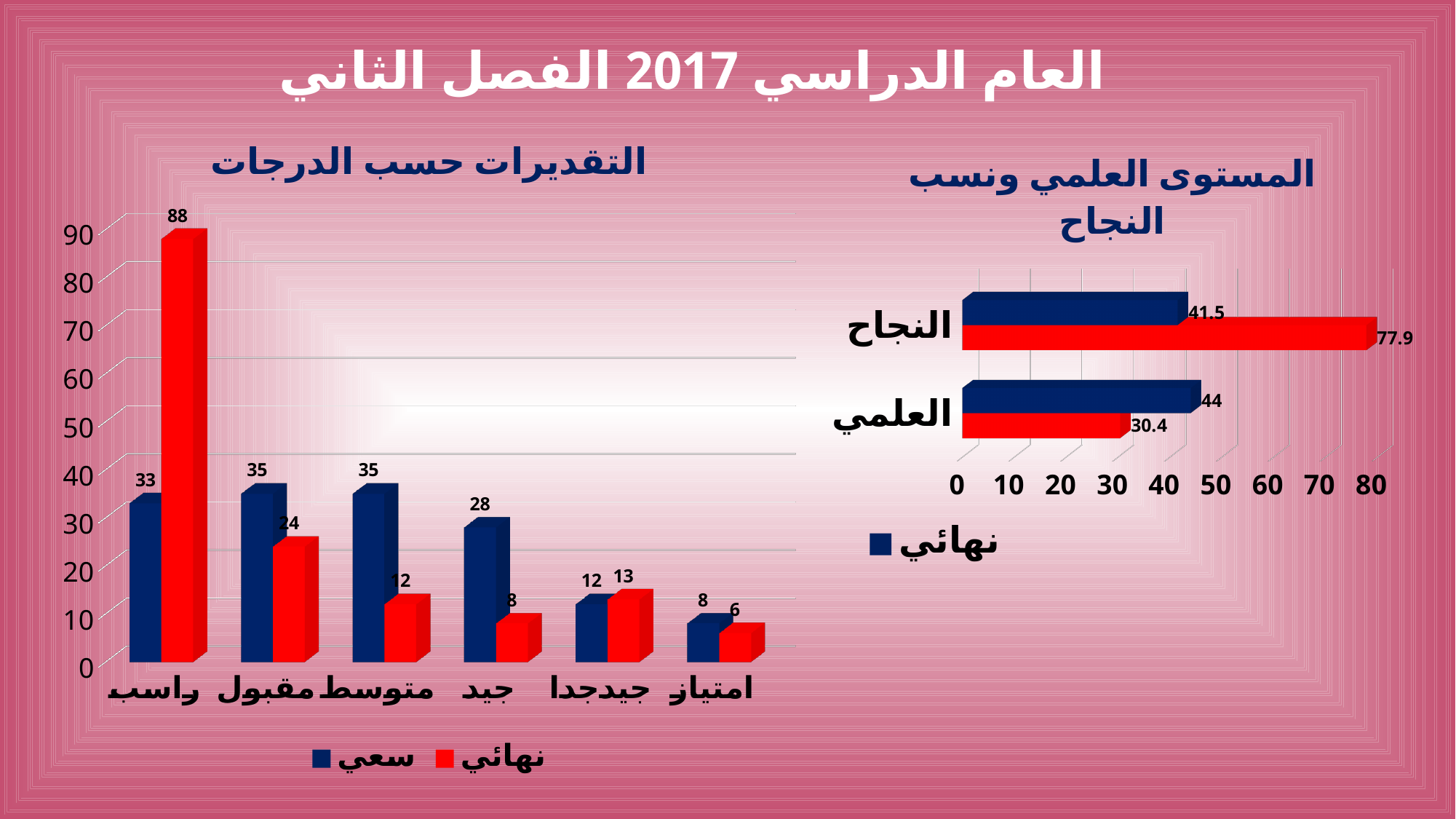
In the chart titled التقديرات حسب الدرجات, which category has the lowest سعي value? امتياز In the chart titled المستوى العلمي ونسب النجاح, what is the red bar value for النجاح? 77.9 In the chart titled التقديرات حسب الدرجات, which is larger for مقبول: the سعي value or the نهائي value? سعي In the chart titled التقديرات حسب الدرجات, what is the سعي value for جيد? 28 In the chart titled التقديرات حسب الدرجات, what is the difference between the نهائي and سعي values for راسب? 55 In the chart titled التقديرات حسب الدرجات, which category has the highest نهائي value? راسب What kind of chart is the one titled المستوى العلمي ونسب النجاح? bar chart In the chart titled المستوى العلمي ونسب النجاح, what is the difference between the two values shown for العلمي? 13.6 In the chart titled التقديرات حسب الدرجات, how many series does the legend list? 2 In the chart titled التقديرات حسب الدرجات, what is the نهائي value for راسب? 88 In the chart titled المستوى العلمي ونسب النجاح, what is the blue (نهائي) value for العلمي? 44 In the chart titled التقديرات حسب الدرجات, how many categories are shown on the x axis? 6